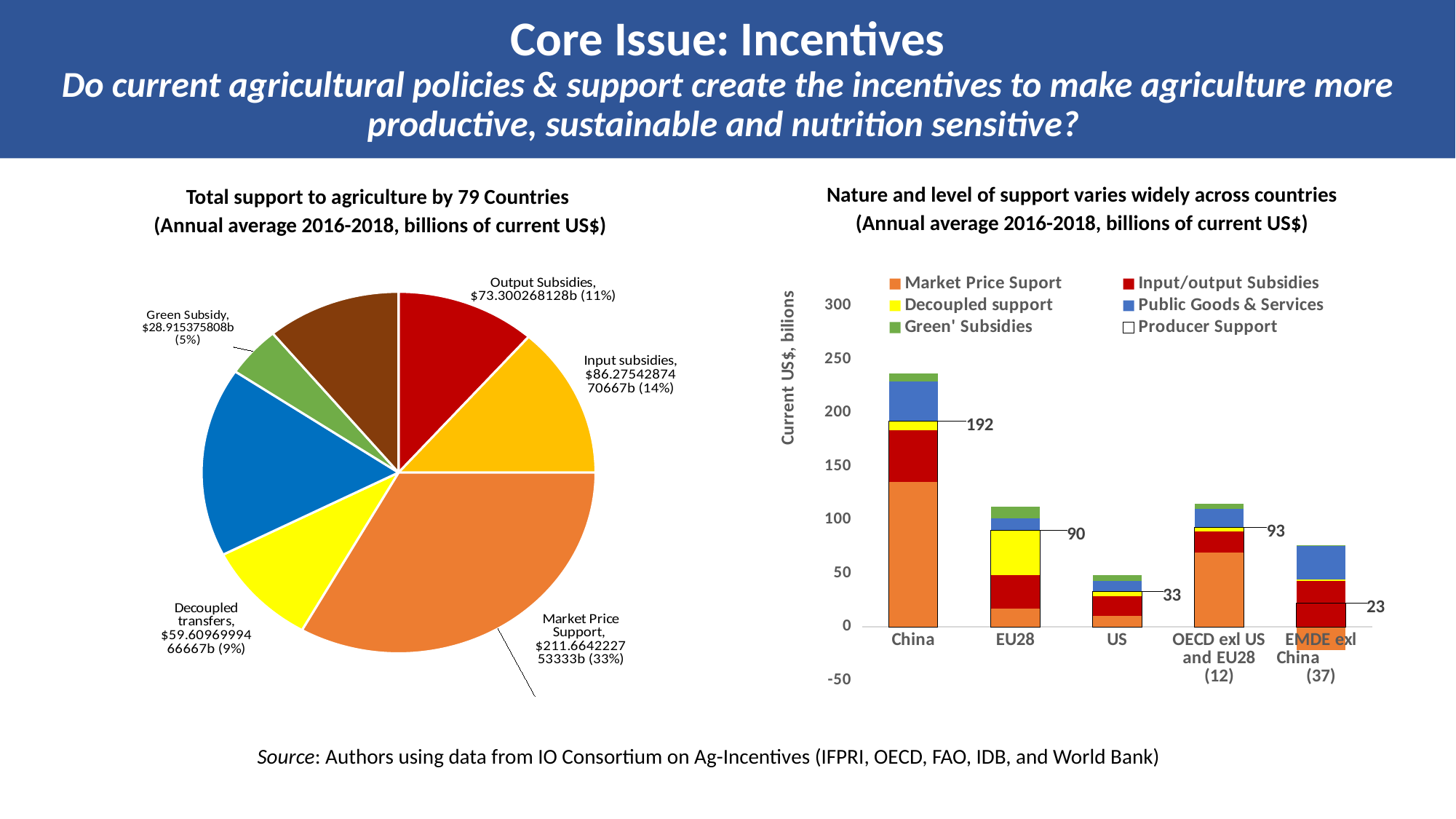
In the pie chart on the left, what percentage share is labelled for Green Subsidy? 5% How many country groups are shown on the x axis of the right-hand chart? 5 What kind of chart is the right-hand chart titled 'Nature and level of support varies widely across countries'? Stacked bar chart In the pie chart on the left, which is larger: Input subsidies or Output Subsidies? Input subsidies In the right-hand chart, which country group has the lowest labelled Producer Support value? EMDE exl China (37) How many series does the legend of the right-hand chart list? 6 In the pie chart on the left, what is the value shown for Output Subsidies? $73.300268128b In the right-hand chart, is the Market Price Support segment for China greater or less than 100? greater In the right-hand chart, what is the difference between the Producer Support values labelled for China and EU28? 102 What kind of chart is the left-hand chart titled 'Total support to agriculture by 79 Countries'? Pie chart In the pie chart on the left, what share of total support is Market Price Support? 33% In the right-hand chart, what is the Producer Support value labelled for China? 192